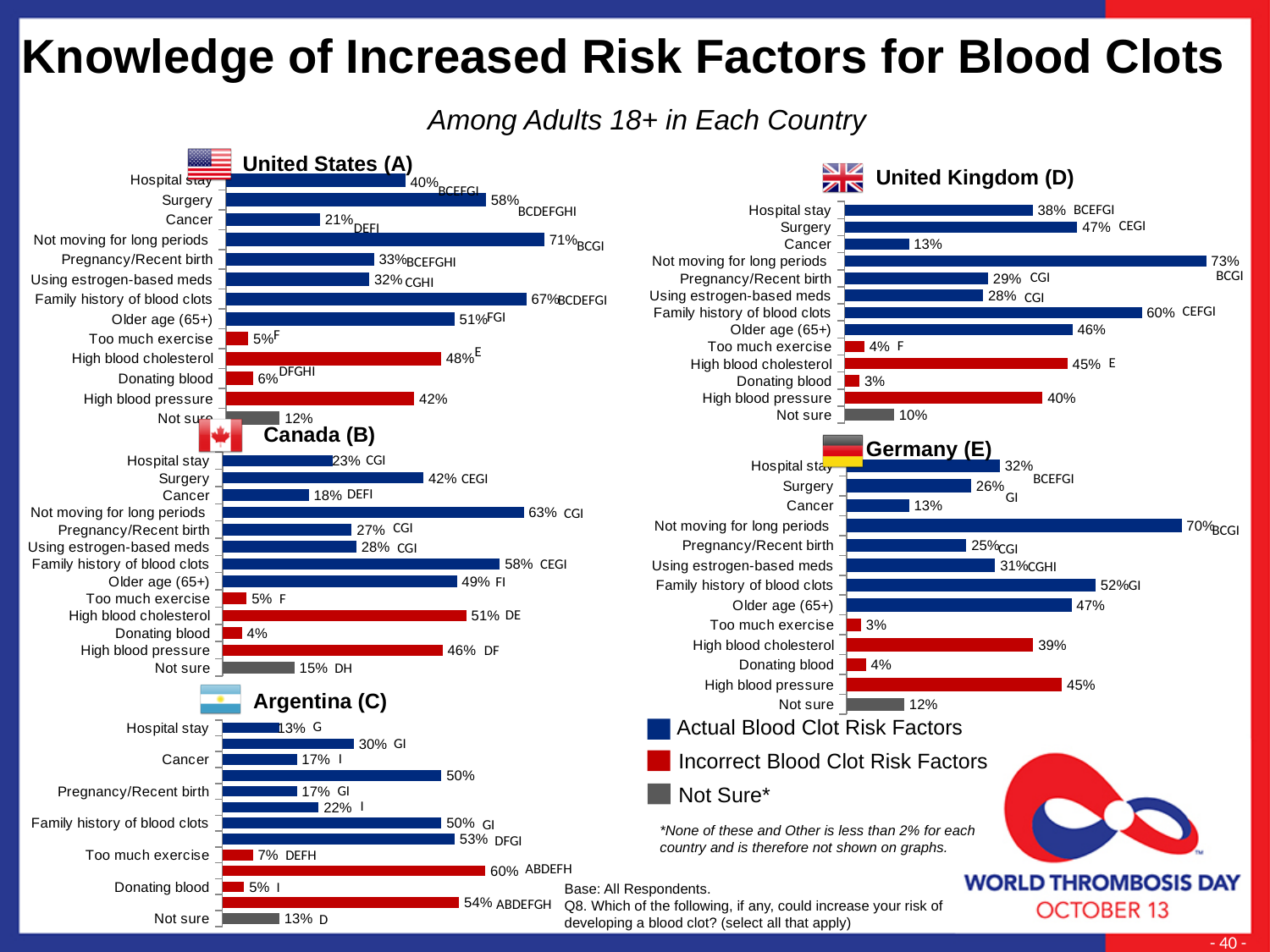
In the Canada (B) chart, what is the difference between the values for Family history of blood clots and Surgery? 16% In the United Kingdom (D) chart, which category has the highest value? Not moving for long periods How many categories are plotted in the Canada (B) chart? 13 In the United States (A) chart, what percentage is shown for Not moving for long periods? 71% According to the legend, what colour represents Incorrect Blood Clot Risk Factors? Red How many series does the legend on the slide list? 3 In the Germany (E) chart, which category has the lowest value? Too much exercise In the United States (A) chart, what is the difference between the values for Surgery and Cancer? 37% In the Germany (E) chart, what percentage is shown for High blood pressure? 45% In the Argentina (C) chart, what percentage is shown for Too much exercise? 7% In the United Kingdom (D) chart, which is larger: the value for Surgery or the value for Older age (65+)? Surgery What type of chart is the United States (A) chart? Bar chart